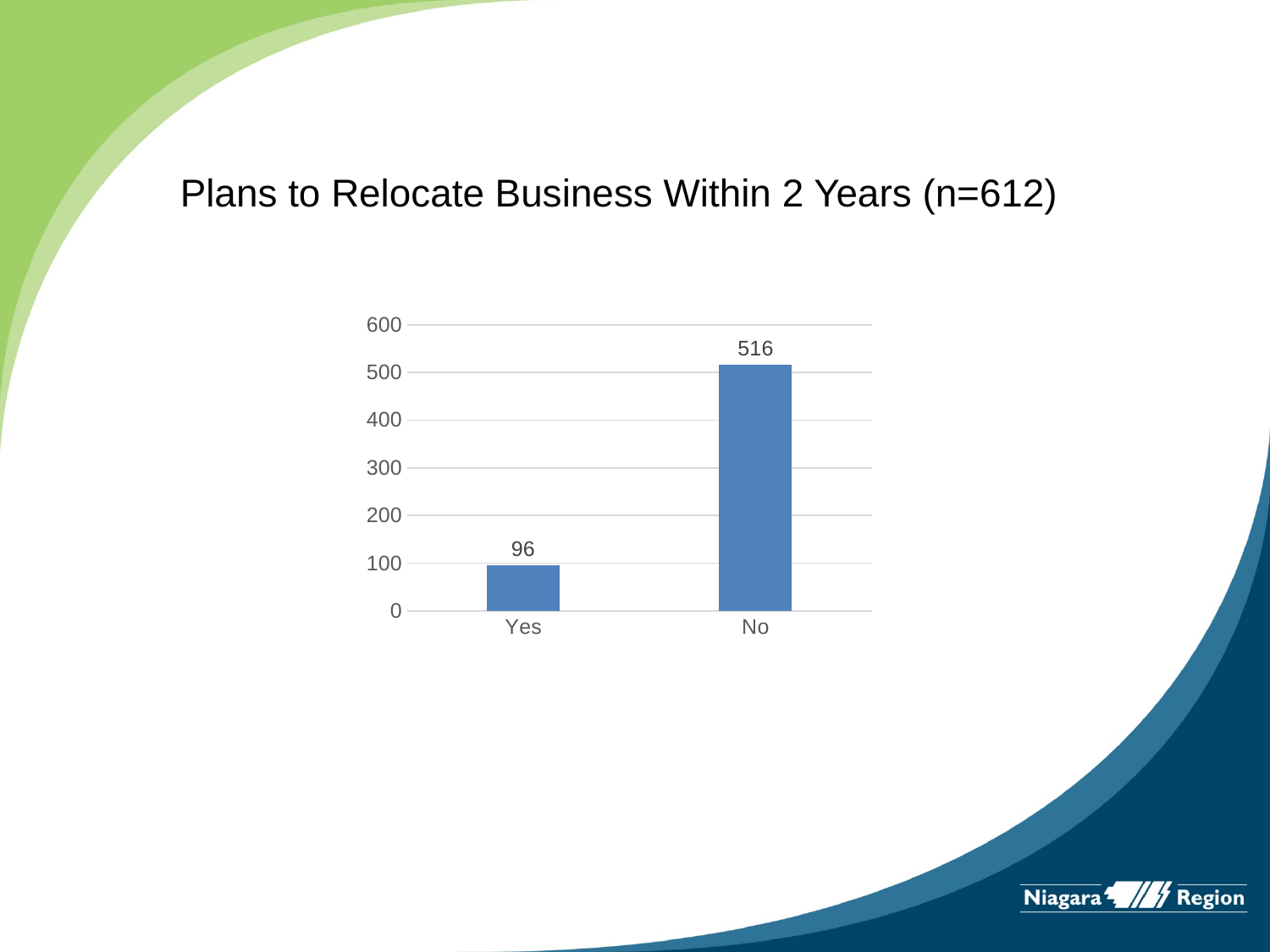
Which category has the lowest value? Yes What is the title of the chart? Plans to Relocate Business Within 2 Years (n=612) Is the value for No greater or less than 500? greater What is the value for Yes? 96 How many categories are shown on the x axis? 2 Is the value for Yes greater or less than 100? less Which category has the highest value? No Which is larger, the value for Yes or the value for No? No What kind of chart is shown on the slide? bar chart What is the difference between the values for No and Yes? 420 What is the highest value shown on the y axis? 600 What is the value for No? 516